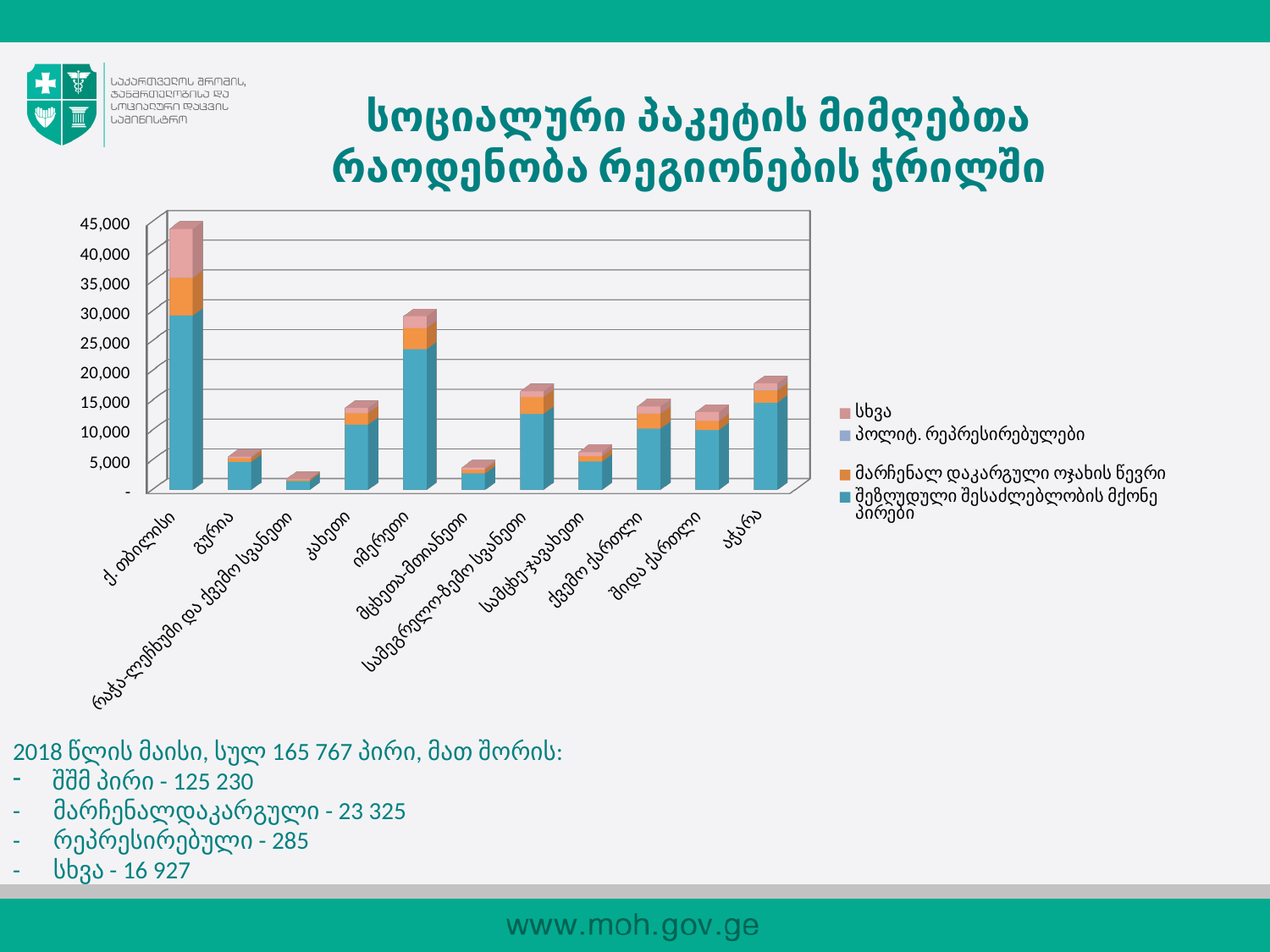
Which region has the tallest bar in the chart? ქ. თბილისი Which bar is taller, ქ. თბილისი or იმერეთი? ქ. თბილისი How many series does the chart legend list? 4 Is the total value for იმერეთი greater or less than 25,000? greater Is the total value for ქ. თბილისი greater or less than 40,000? greater Is the total value for რაჭა-ლეჩხუმი და ქვემო სვანეთი greater or less than 5,000? less Which bar is taller, იმერეთი or კახეთი? იმერეთი What kind of chart is shown on the slide? stacked bar chart Which legend entry is shown in orange? მარჩენალ დაკარგული ოჯახის წევრი How many regions (categories) are shown on the x axis of the chart? 11 Which region has the shortest bar in the chart? რაჭა-ლეჩხუმი და ქვემო სვანეთი